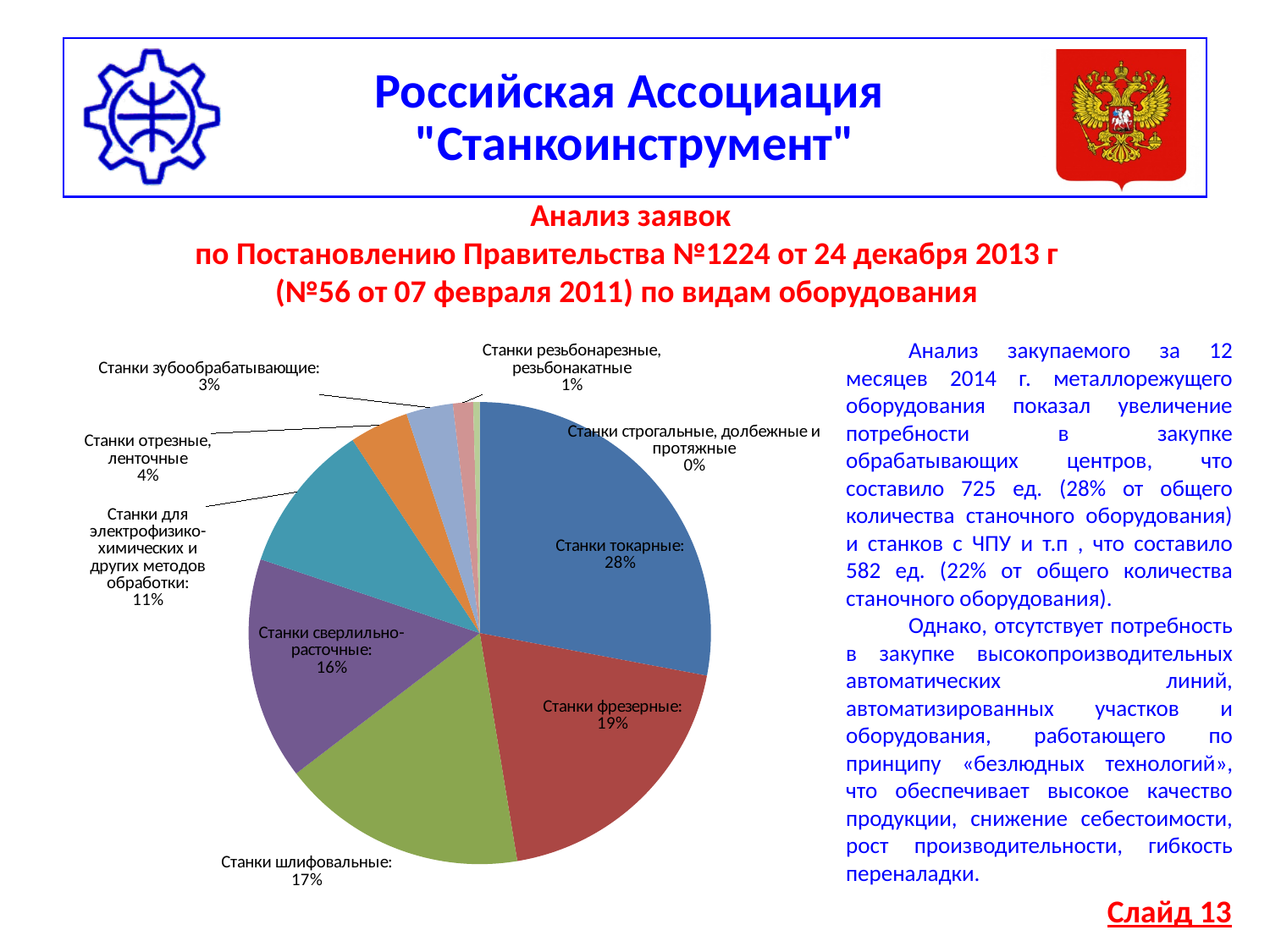
What kind of chart is shown on the slide? pie chart How many categories are shown in the pie chart? 9 What share of the pie is Станки сверлильно-расточные? 16% What is the difference in percentage points between Станки токарные and Станки фрезерные? 9 Which category has the largest share of the pie? Станки токарные What share of the pie is Станки зубообрабатывающие? 3% What share of the pie is Станки для электрофизико-химических и других методов обработки? 11% What share of the pie is Станки шлифовальные? 17% What share of the pie is Станки фрезерные? 19% What share of the pie is Станки токарные? 28% Which is larger: the share for Станки отрезные, ленточные or the share for Станки зубообрабатывающие? Станки отрезные, ленточные Which category has the smallest share of the pie? Станки строгальные, долбежные и протяжные